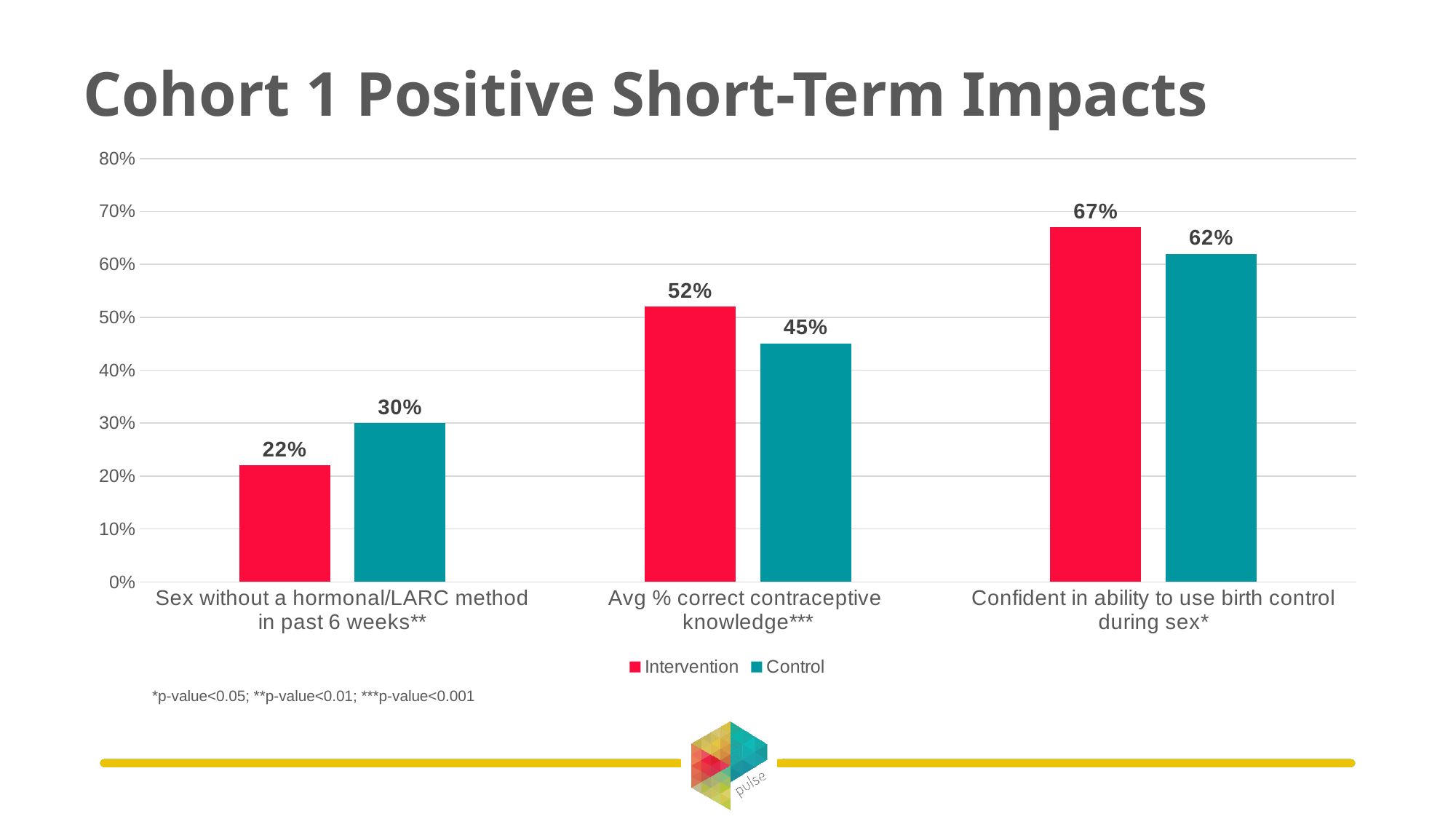
What is the title of the slide? Cohort 1 Positive Short-Term Impacts What is the Control value for "Avg % correct contraceptive knowledge"? 45% Which category has the lowest Intervention value? Sex without a hormonal/LARC method in past 6 weeks How many series does the legend list? 2 Which category has the highest Control value? Confident in ability to use birth control during sex How many categories are shown on the x axis? 3 What is the difference between the Intervention and Control values for "Avg % correct contraceptive knowledge"? 7% For "Sex without a hormonal/LARC method in past 6 weeks", which group has the larger value, Intervention or Control? Control What is the Intervention value for "Sex without a hormonal/LARC method in past 6 weeks"? 22% Is the Control value for "Confident in ability to use birth control during sex" greater or less than 60%? greater What kind of chart is shown on the slide? Bar chart What is the Intervention value for "Confident in ability to use birth control during sex"? 67%